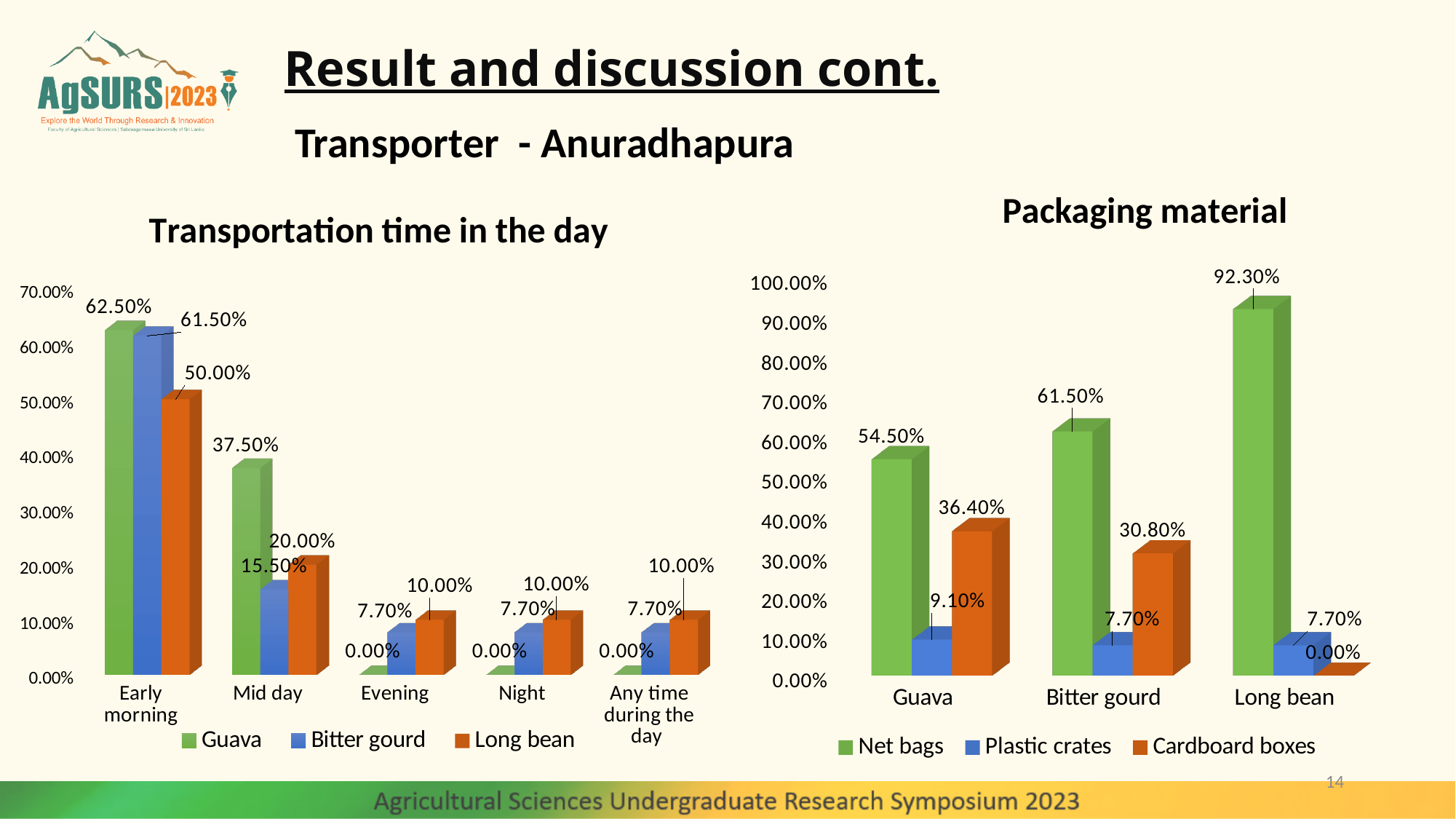
In the 'Transportation time in the day' chart, what is the value for Long bean at Early morning? 50.00% In the 'Packaging material' chart, what is the value for Cardboard boxes for Guava? 36.40% In the 'Transportation time in the day' chart, what is the value for Guava at Early morning? 62.50% In the 'Packaging material' chart, how many series does the legend list? 3 In the 'Packaging material' chart, what is the value for Net bags for Long bean? 92.30% In the 'Packaging material' chart, which is larger for Bitter gourd: Plastic crates or Cardboard boxes? Cardboard boxes In the 'Packaging material' chart, which crop has the lowest value for Net bags? Guava In the 'Transportation time in the day' chart, what is the difference between Guava and Long bean at Mid day? 17.50% In the 'Transportation time in the day' chart, which category has the highest value for Guava? Early morning In the 'Transportation time in the day' chart, how many categories are shown on the x axis? 5 In the 'Transportation time in the day' chart, what is the value for Bitter gourd at Mid day? 15.50% What kind of chart is the 'Packaging material' chart? Bar chart